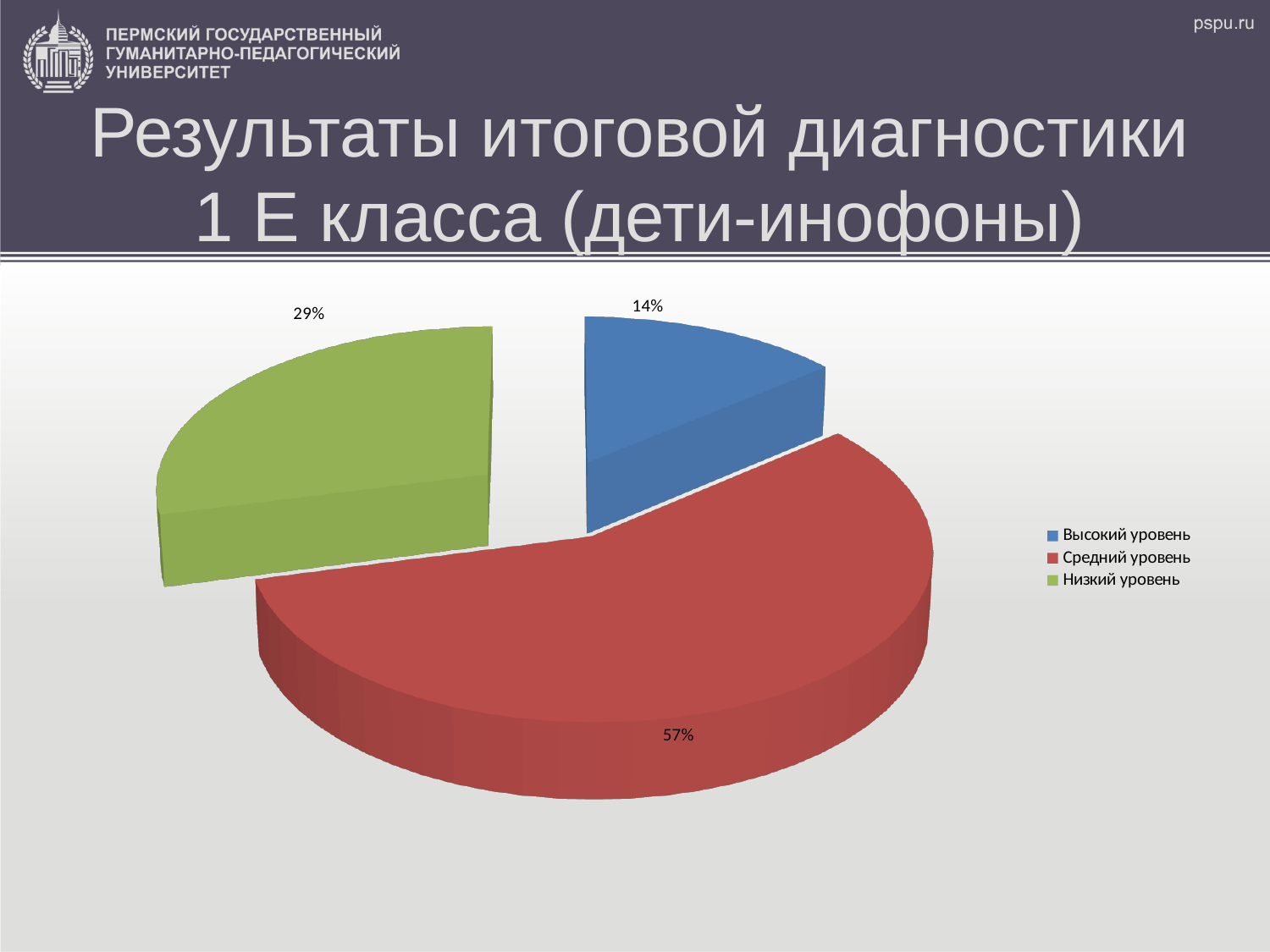
What share of the pie does Высокий уровень have? 14% Which category has the smallest slice of the pie? Высокий уровень What is the difference in percentage points between Средний уровень and Низкий уровень? 28 Which category has the largest slice of the pie? Средний уровень What colour is the slice for Средний уровень? Red What share of the pie does Низкий уровень have? 29% Which legend entry is shown in green? Низкий уровень What is the difference in percentage points between Низкий уровень and Высокий уровень? 15 What share of the pie does Средний уровень have? 57% Which is larger, the slice for Низкий уровень or the slice for Высокий уровень? Низкий уровень How many categories does the pie chart show? 3 What kind of chart is shown on the slide? Pie chart